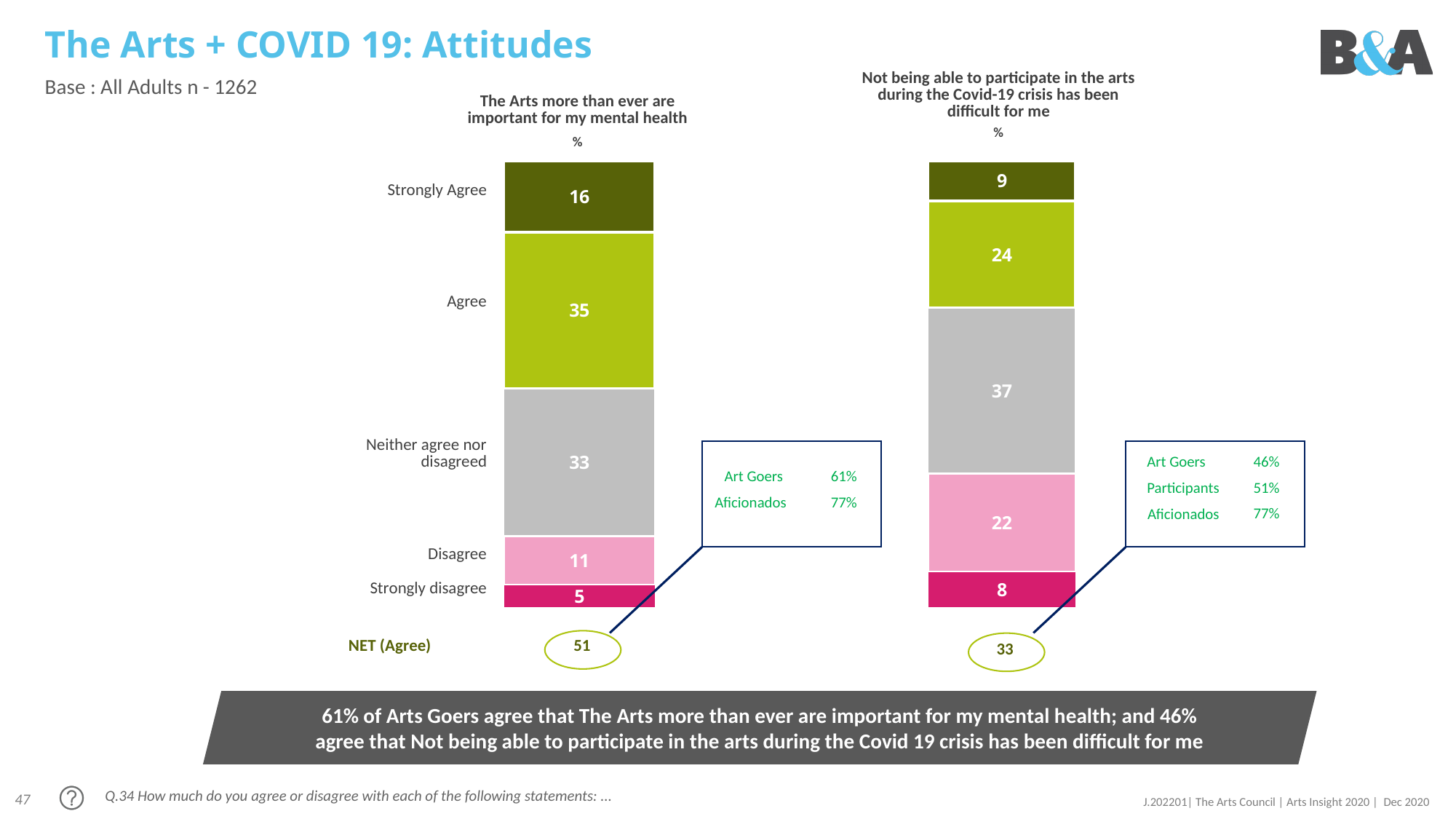
What is the NET (Agree) value shown for the chart titled 'Not being able to participate in the arts during the Covid-19 crisis has been difficult for me'? 33 In the chart titled 'Not being able to participate in the arts during the Covid-19 crisis has been difficult for me', what is the value for Strongly Agree? 9 In the chart titled 'The Arts more than ever are important for my mental health', what is the value for Strongly disagree? 5 In the chart titled 'Not being able to participate in the arts during the Covid-19 crisis has been difficult for me', which response category has the lowest value? Strongly disagree In the chart titled 'The Arts more than ever are important for my mental health', which response category has the highest value? Agree In the chart titled 'The Arts more than ever are important for my mental health', what is the value for Agree? 35 In the box next to the chart titled 'The Arts more than ever are important for my mental health', what percentage is shown for Aficionados? 77% What kind of chart is used on this slide? Stacked bar chart In the chart titled 'The Arts more than ever are important for my mental health', what is the difference between the Agree and Strongly Agree values? 19 How many response categories are shown in each stacked bar? 5 Which chart has the larger Disagree value: 'The Arts more than ever are important for my mental health' or 'Not being able to participate in the arts during the Covid-19 crisis has been difficult for me'? Not being able to participate in the arts during the Covid-19 crisis has been difficult for me In the chart titled 'Not being able to participate in the arts during the Covid-19 crisis has been difficult for me', what is the value for Neither agree nor disagreed? 37